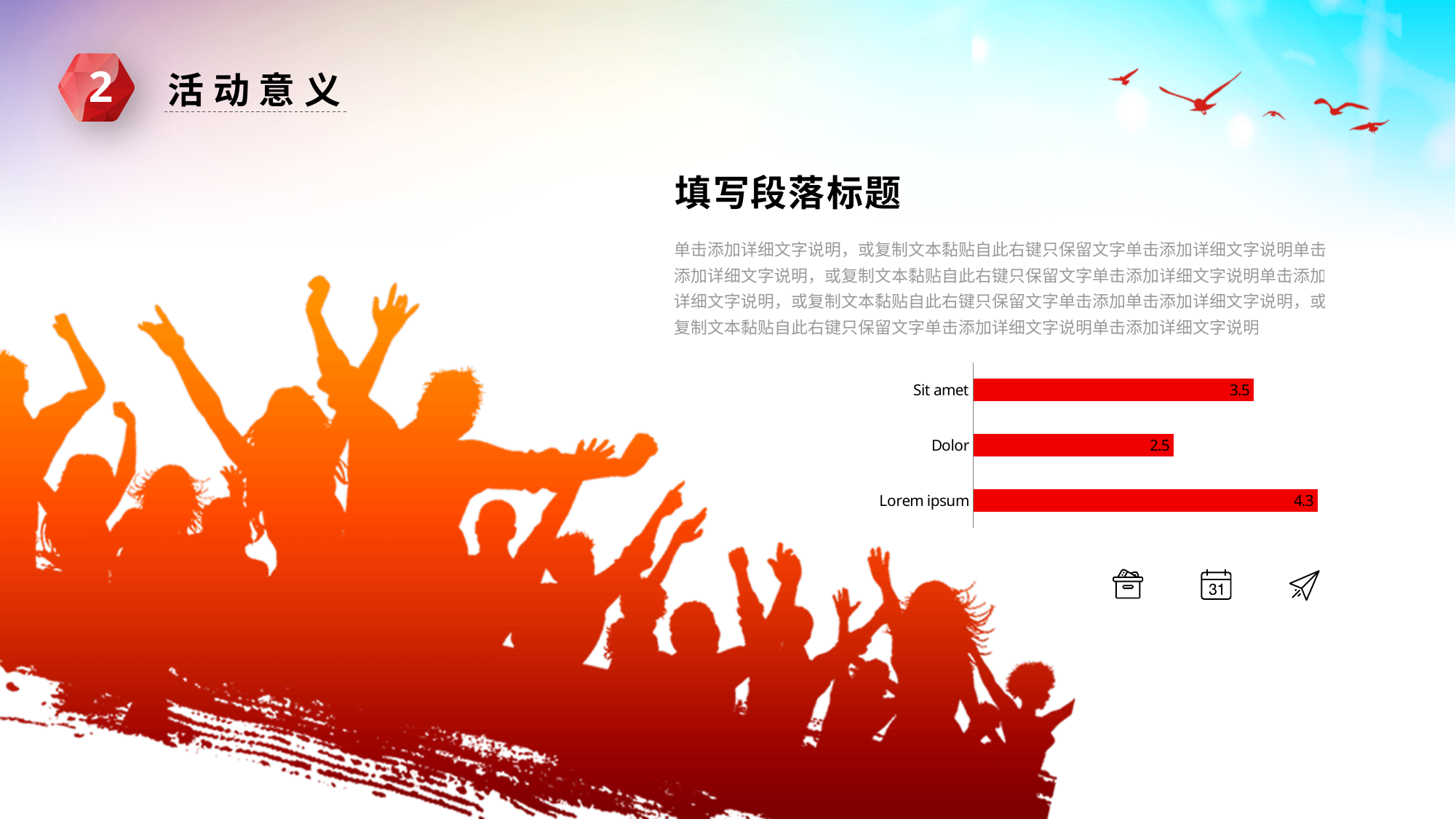
What is the value for Dolor? 2.5 What is the difference between the values for Lorem ipsum and Dolor? 1.8 Are the bars in the chart horizontal or vertical? horizontal What kind of chart is shown on the slide? bar chart What is the difference between the values for Sit amet and Dolor? 1 Which category has the lowest value? Dolor What is the value for Sit amet? 3.5 What is the value for Lorem ipsum? 4.3 Which is larger, the value for Sit amet or the value for Lorem ipsum? Lorem ipsum How many categories are shown in the chart? 3 What colour are the bars in the chart? red Which category has the highest value? Lorem ipsum